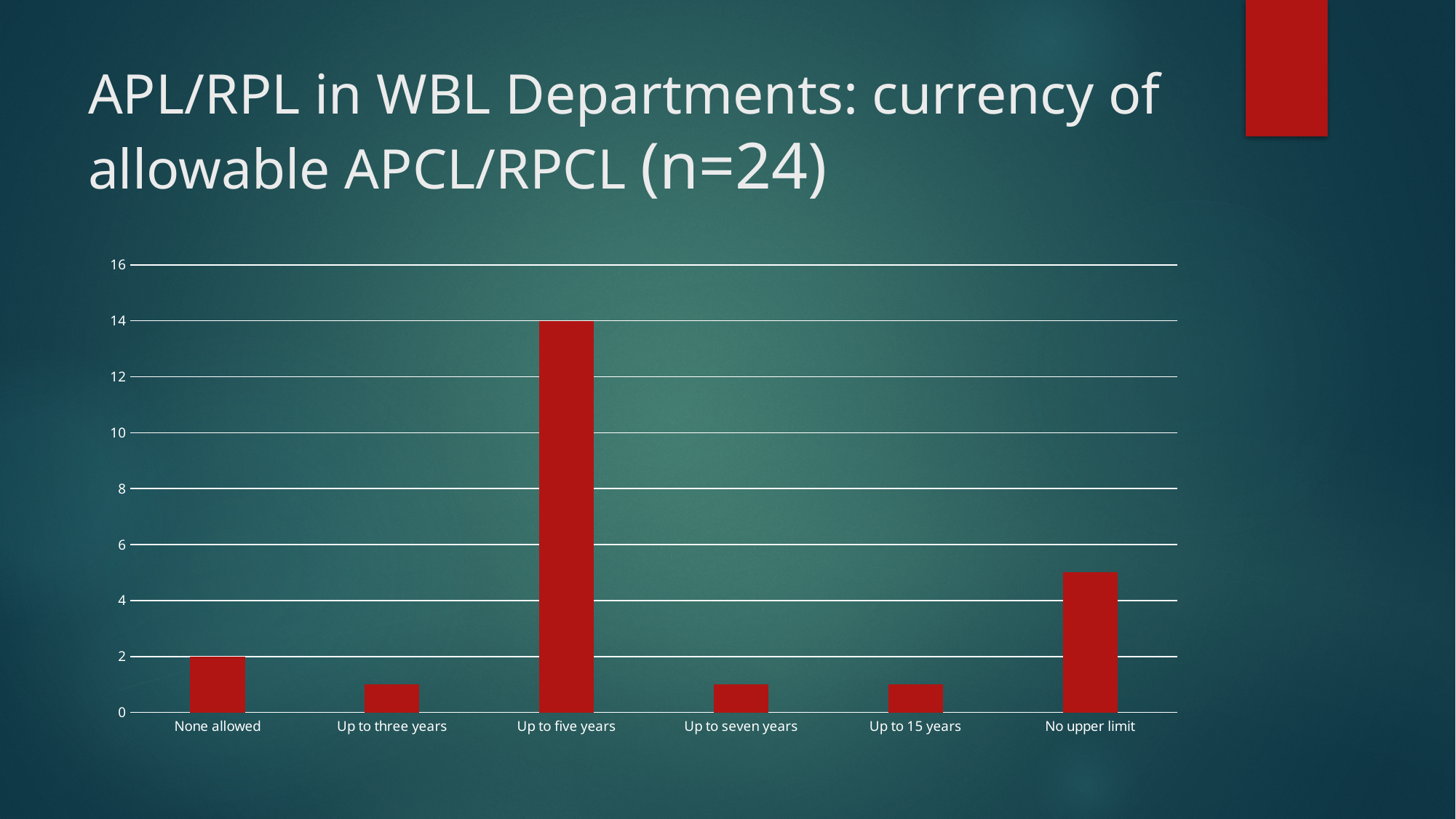
Is the value for "No upper limit" greater or less than 4? greater What is the value for "Up to five years"? 14 Which category has the highest value in the chart? Up to five years What is the title of the slide containing the chart? APL/RPL in WBL Departments: currency of allowable APCL/RPCL (n=24) What kind of chart is shown on the slide? bar chart Is the value for "No upper limit" greater or less than 6? less What is the value for "None allowed"? 2 Which is larger, the value for "Up to five years" or the value for "No upper limit"? Up to five years How many categories are shown on the x axis of the chart? 6 Which is larger, the value for "None allowed" or the value for "Up to seven years"? None allowed What is the difference between the values for "Up to five years" and "None allowed"? 12 Is the value for "Up to three years" greater or less than 2? less